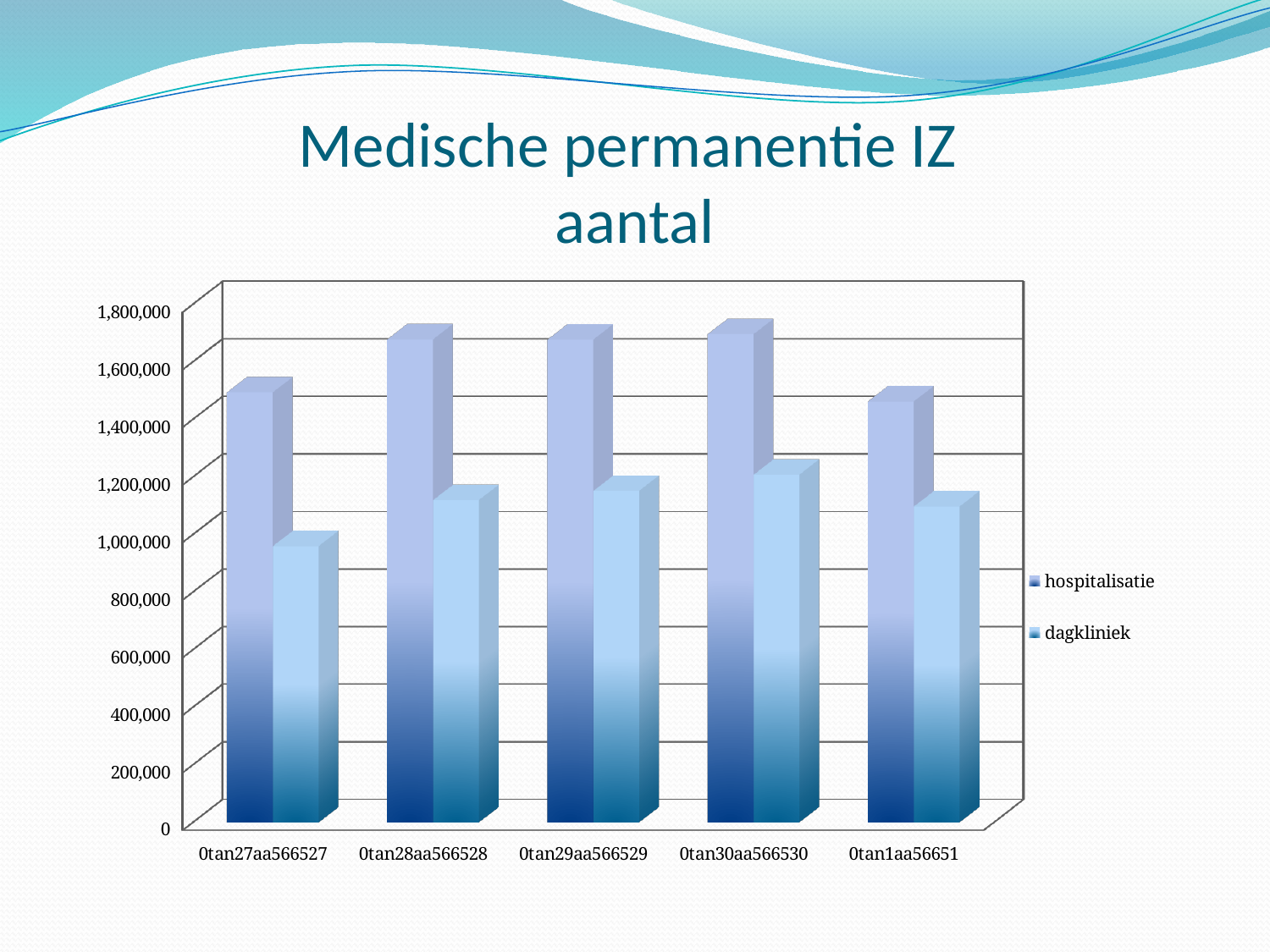
Which category has the lowest dagkliniek value? 0tan27aa566527 Which series are listed in the legend? hospitalisatie and dagkliniek What is the title of the chart? Medische permanentie IZ aantal Does the dagkliniek value rise or fall from 0tan27aa566527 to 0tan30aa566530? rise How many categories are shown on the x axis? 5 Is the hospitalisatie value for 0tan27aa566527 greater or less than 1,400,000? greater For 0tan29aa566529, which is larger: hospitalisatie or dagkliniek? hospitalisatie Is the dagkliniek value for 0tan27aa566527 greater or less than 1,200,000? less Is the dagkliniek value for 0tan30aa566530 greater or less than 1,000,000? greater How many series does the legend list? 2 What kind of chart is shown on the slide? bar chart